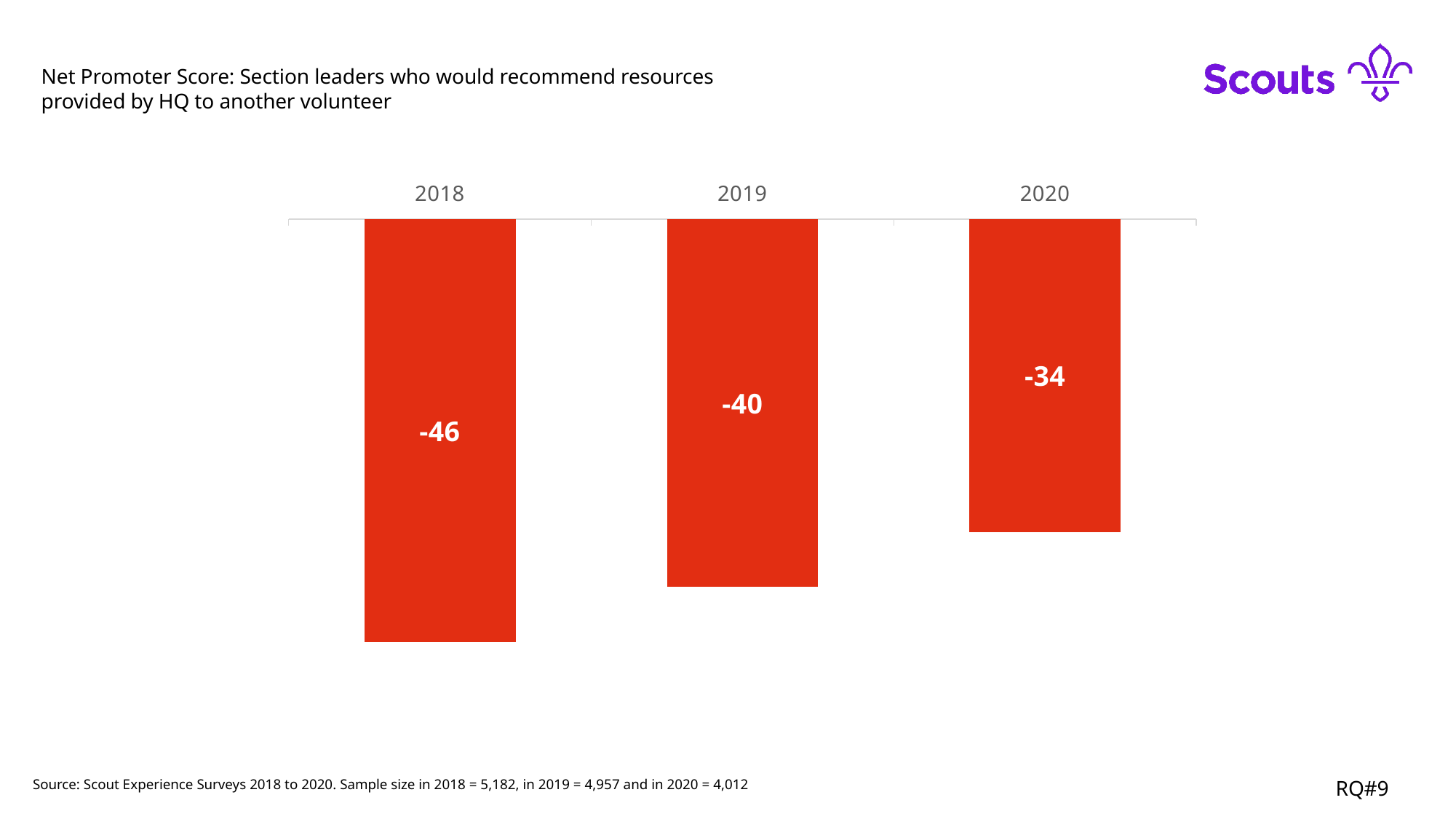
What is the difference between the Net Promoter Score in 2019 and in 2018? 6 What colour are the bars in the chart? Red Do the Net Promoter Scores rise or fall from 2018 to 2020? Rise What is the difference between the Net Promoter Score in 2020 and in 2018? 12 Which year has the lowest Net Promoter Score? 2018 What is the Net Promoter Score for 2018? -46 Which year has the highest Net Promoter Score? 2020 What is the Net Promoter Score for 2020? -34 Which is larger, the Net Promoter Score for 2019 or for 2020? 2020 What kind of chart is shown on the slide? Bar chart What is the Net Promoter Score for 2019? -40 How many years are shown in the chart? 3